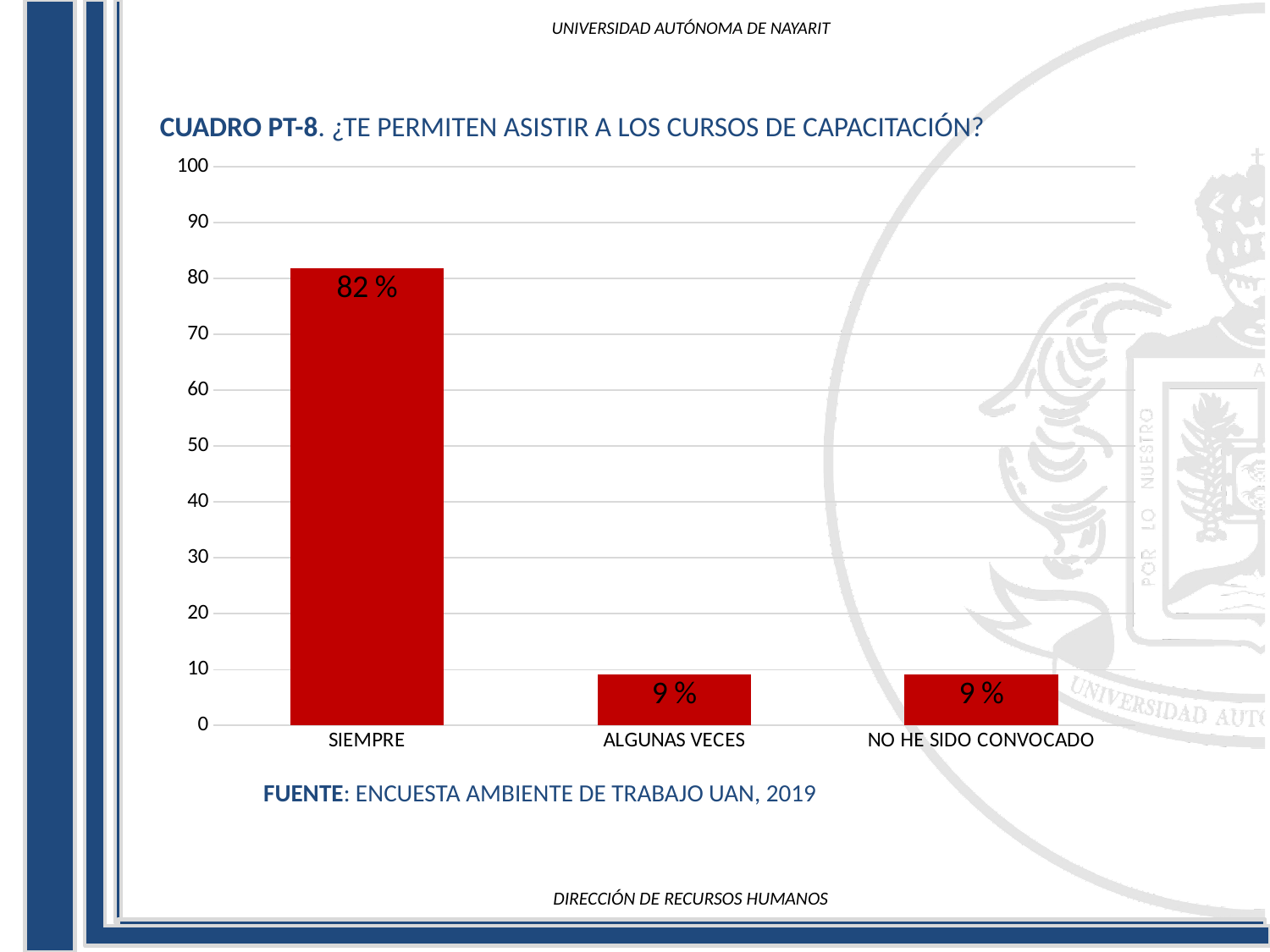
Is the value for SIEMPRE greater or less than 50? greater Which category has the highest value? SIEMPRE Which is larger, the value for SIEMPRE or the value for NO HE SIDO CONVOCADO? SIEMPRE How many categories are shown on the x axis? 3 What is the value for SIEMPRE? 82 % Is the value for ALGUNAS VECES greater or less than 20? less What is the value for ALGUNAS VECES? 9 % What is the difference between the values for SIEMPRE and ALGUNAS VECES? 73 % What is the value for NO HE SIDO CONVOCADO? 9 % What kind of chart is shown on the slide? bar chart What is the source cited below the chart? ENCUESTA AMBIENTE DE TRABAJO UAN, 2019 What is the title of the chart? CUADRO PT-8. ¿TE PERMITEN ASISTIR A LOS CURSOS DE CAPACITACIÓN?